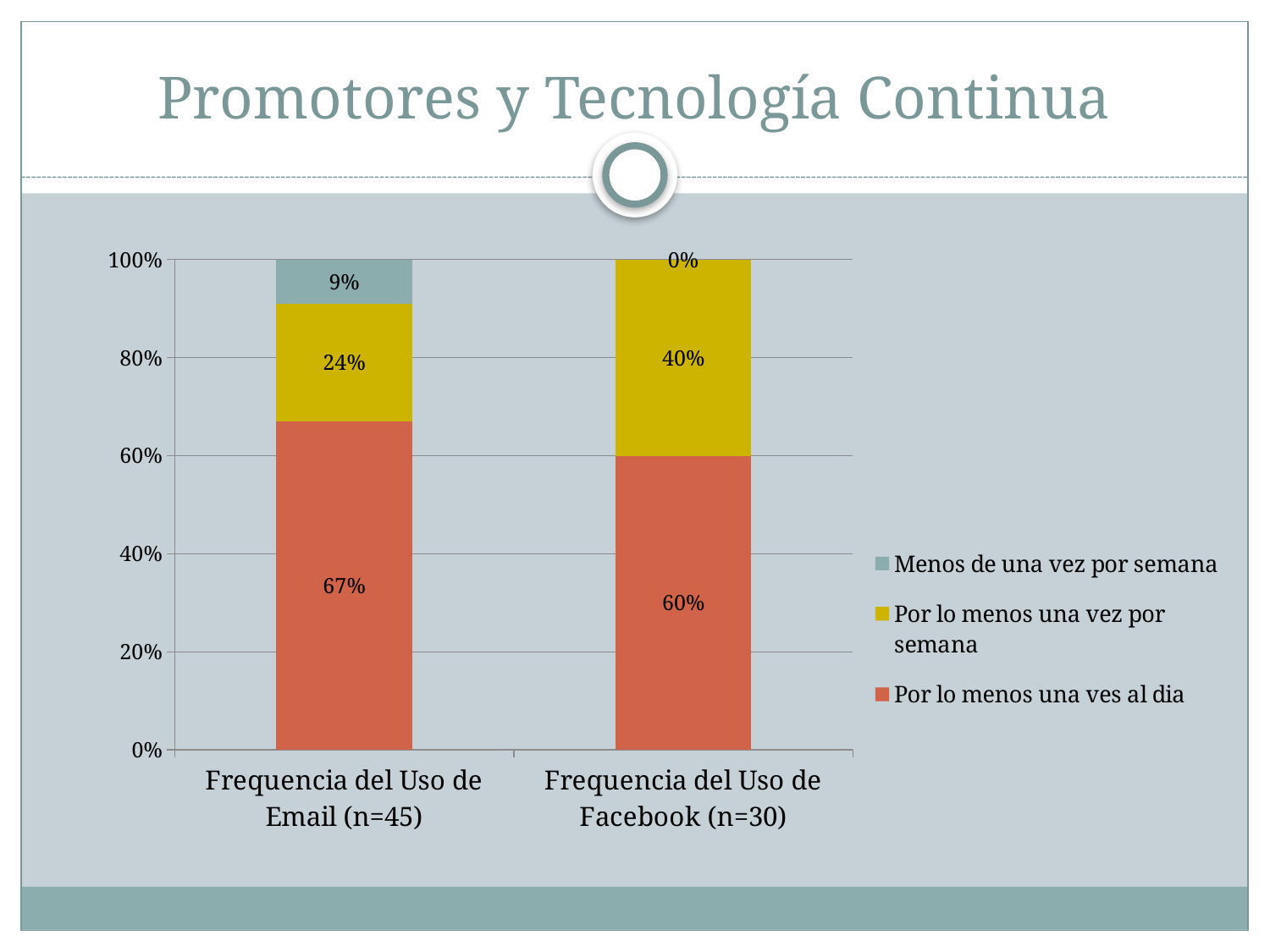
What percentage of the Facebook bar is 'Por lo menos una vez por semana'? 40% Which category has the higher value for 'Por lo menos una ves al dia', Email or Facebook? Frequencia del Uso de Email (n=45) What is the difference between the 'Por lo menos una ves al dia' values for Email and Facebook? 7% How many series does the legend list? 3 What is the difference between the 'Por lo menos una vez por semana' values for Facebook and Email? 16% What kind of chart is shown on the slide? Stacked bar chart What is the sample size shown for the Facebook category? n=30 What percentage of the Email bar is 'Por lo menos una ves al dia'? 67% What percentage of the Facebook bar is 'Menos de una vez por semana'? 0% What percentage of the Email bar is 'Por lo menos una vez por semana'? 24% What percentage of the Email bar is 'Menos de una vez por semana'? 9% How many categories are shown on the x axis? 2